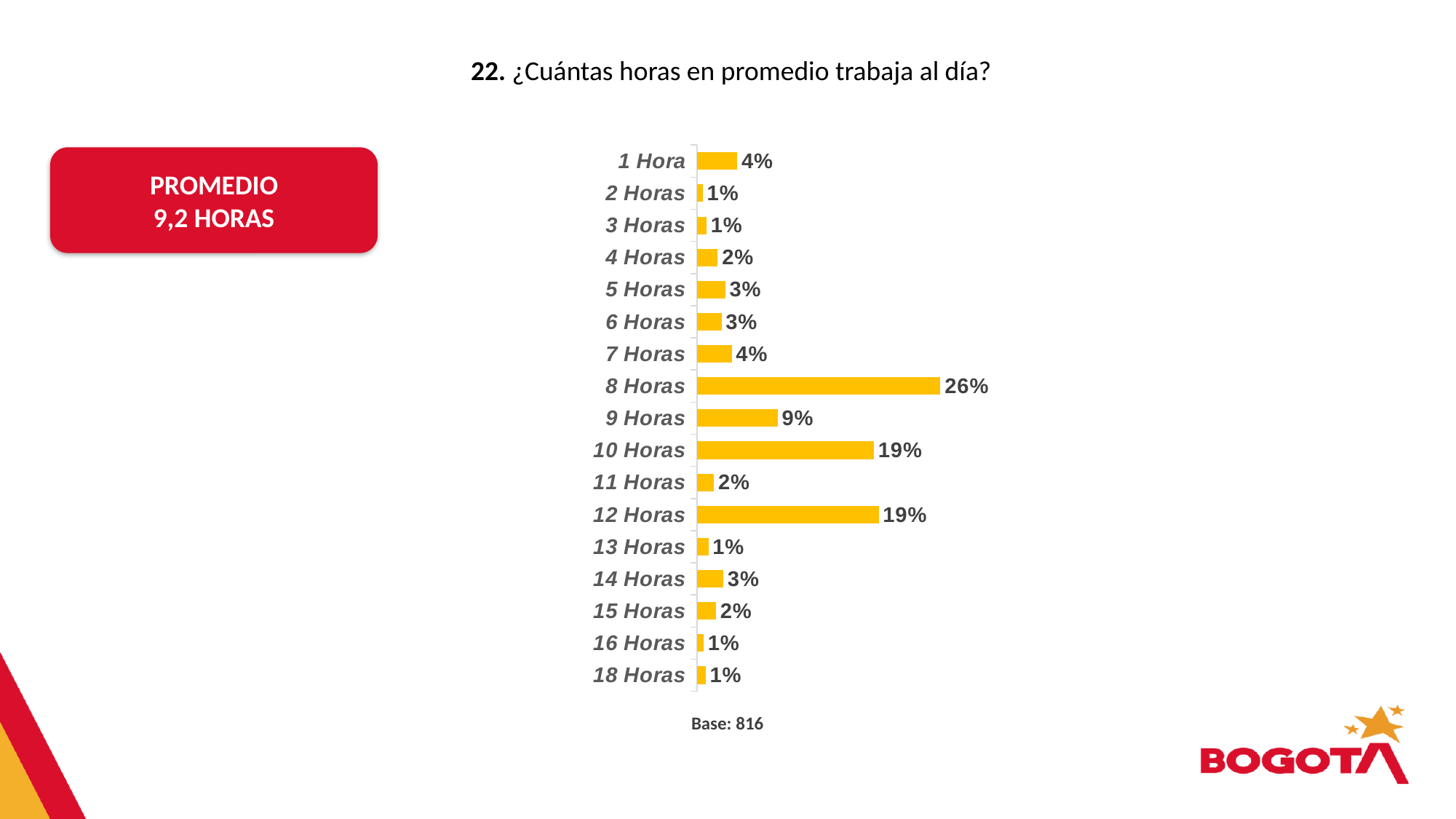
What is the difference between the values for 9 Horas and 1 Hora? 5% Which is larger, the value for 7 Horas or the value for 11 Horas? 7 Horas What kind of chart is shown on the slide? Bar chart Which is larger, the value for 12 Horas or the value for 9 Horas? 12 Horas What percentage of respondents work 8 Horas per day? 26% How many categories (hour values) are shown in the chart? 17 What is the value shown for 10 Horas? 19% What is the base (number of respondents) stated below the chart? 816 Which category has the highest value in the chart? 8 Horas What average number of hours is shown in the red box on the slide? 9,2 HORAS What is the difference between the values for 8 Horas and 10 Horas? 7% What is the value shown for 9 Horas? 9%